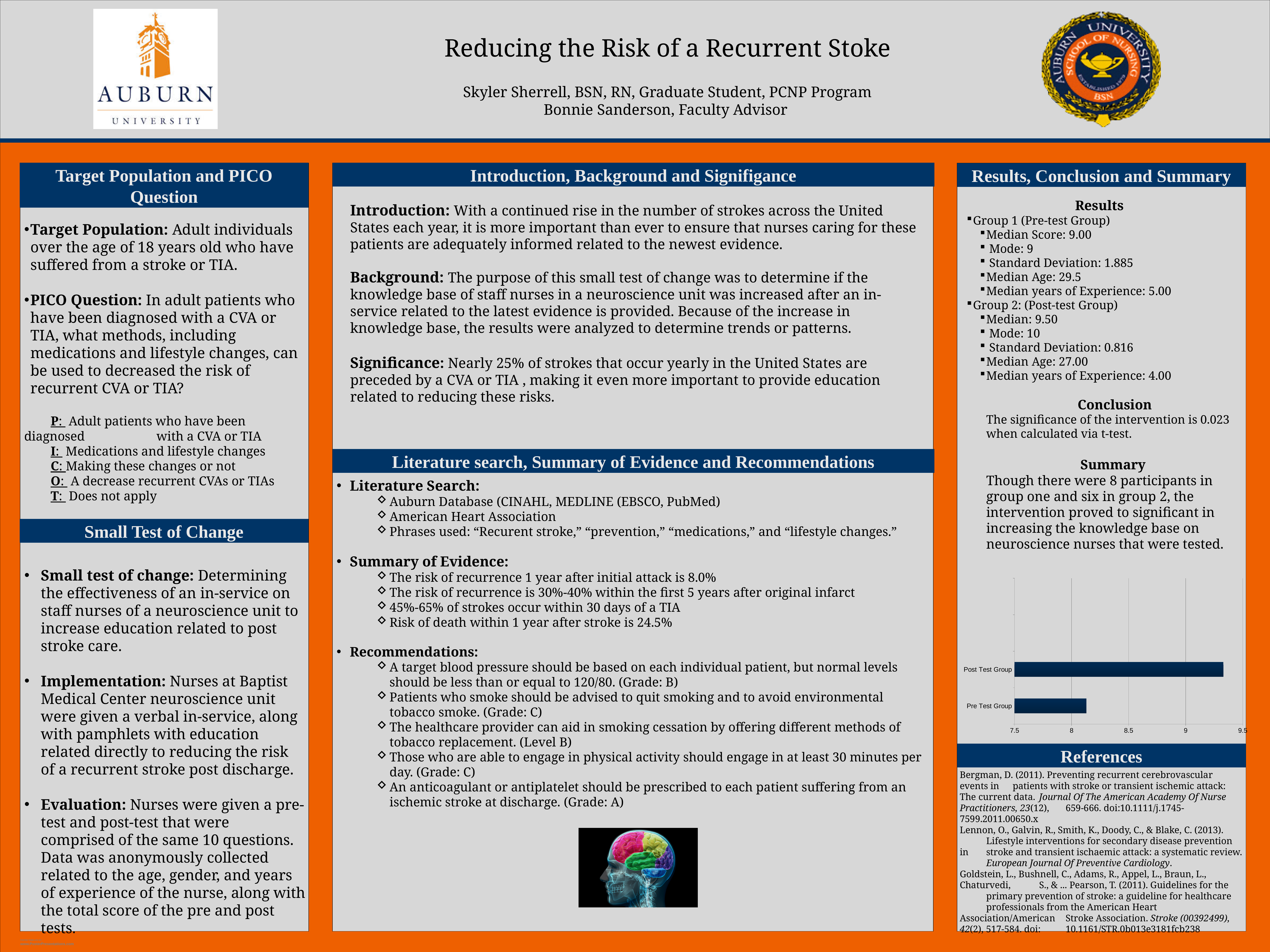
Is the value for the Pre Test Group greater or less than 8.5? less What is the highest tick value shown on the chart's horizontal axis? 9.5 Is the value for the Post Test Group greater or less than 9? greater What is the lowest tick value shown on the chart's horizontal axis? 7.5 Which group has the shorter bar in the chart? Pre Test Group Is the value for the Post Test Group greater or less than 9.5? less What kind of chart is shown at the bottom of the Results, Conclusion and Summary column? bar chart Is the bar for the Post Test Group longer or shorter than the bar for the Pre Test Group? longer Which group has the longer bar in the chart? Post Test Group How many categories are plotted in the bar chart? 2